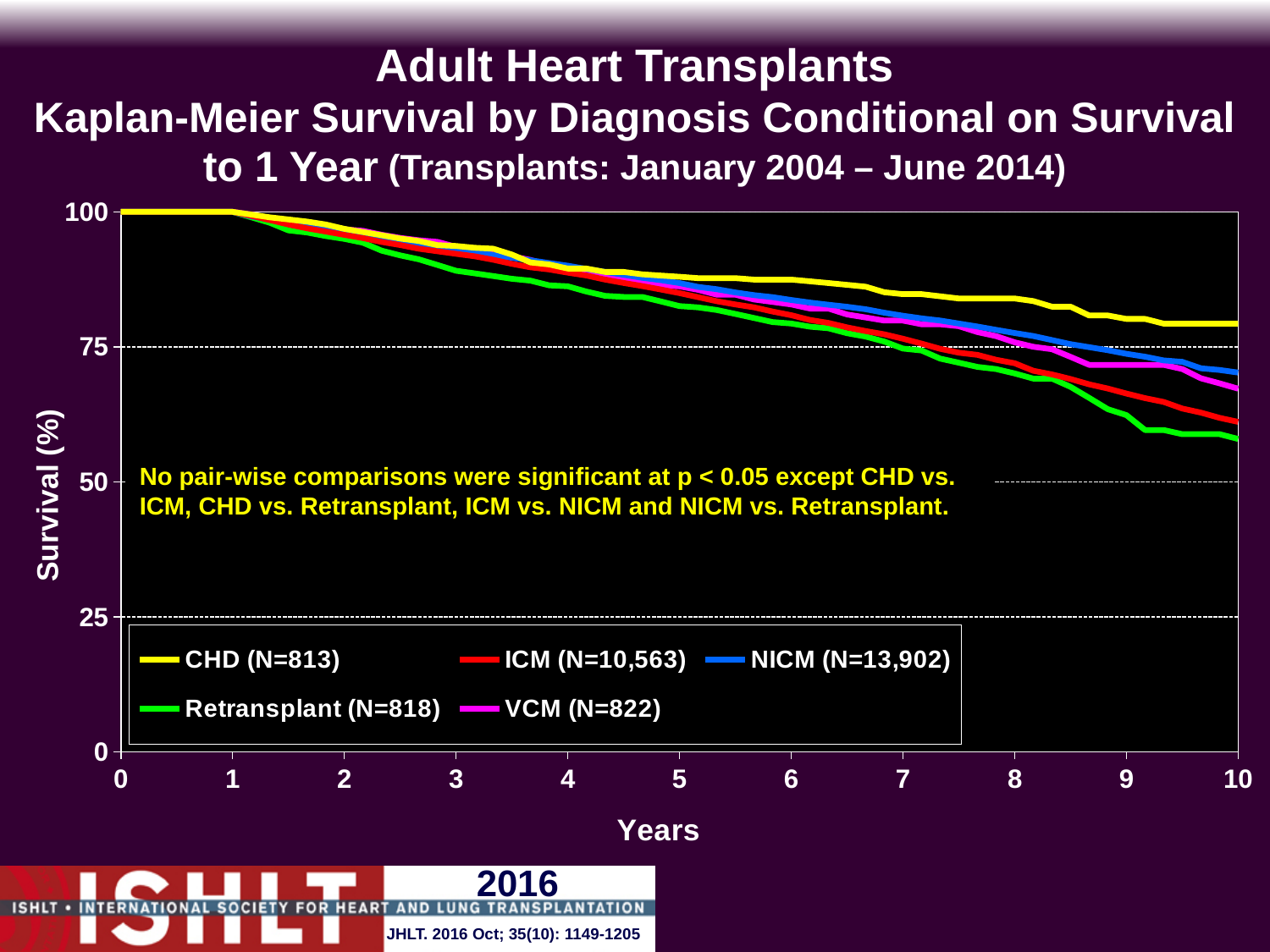
At 10 years, which has higher survival, NICM or ICM? NICM What is the N for the NICM group shown in the legend? 13,902 Which diagnosis group has the lowest survival at 10 years? Retransplant Is the survival for Retransplant at 10 years greater or less than 50? greater How many series does the legend list? 5 Which diagnosis group has the highest survival at 10 years? CHD Is the survival for ICM at 5 years greater or less than 75? greater Do the survival curves rise or fall as years increase? Fall Is the survival for Retransplant at 10 years greater or less than 75? less What is the survival (%) for all groups at 1 year? 100 What kind of chart is shown on the slide? Line chart